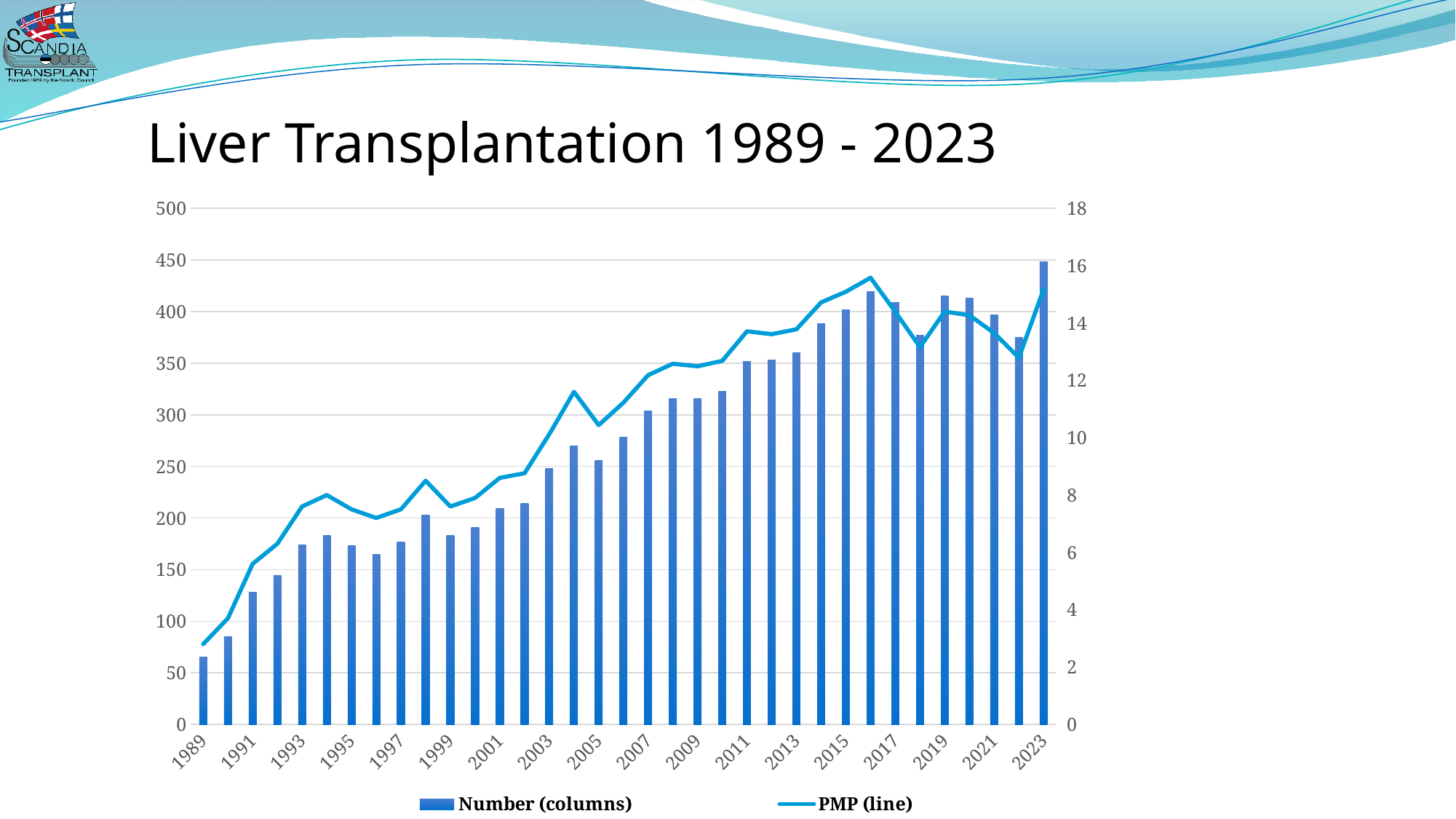
What is the title of the chart? Liver Transplantation 1989 - 2023 How many years (bars) are plotted on the chart? 35 What kind of chart is shown on the slide? A combined bar and line chart Is the PMP value in 1989 greater or less than 4? less Is the number of liver transplantations in 1989 greater or less than 100? less Is the number of liver transplantations in 2005 greater or less than 300? less Which year has the highest number of liver transplantations (tallest bar)? 2023 Which year has the lowest number of liver transplantations (shortest bar)? 1989 How many series does the legend list? 2 Overall, does the number of liver transplantations rise or fall from 1989 to 2023? rise Which year has the larger number of liver transplantations, 2016 or 2022? 2016